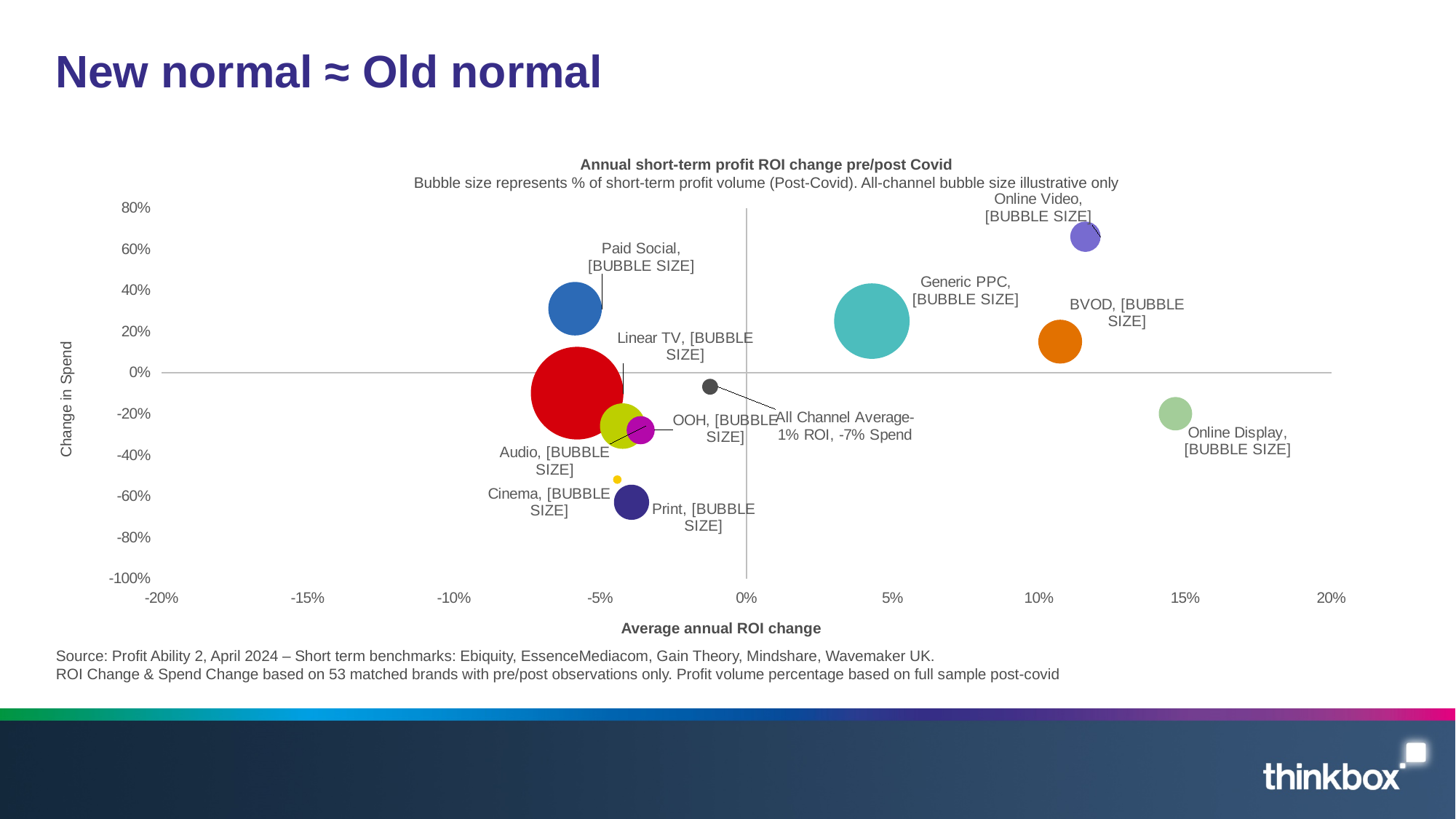
What is the label of the vertical axis? Change in Spend Is the average annual ROI change for Generic PPC greater or less than 5%? less Which channel has the lowest change in spend? Print Which has the larger change in spend, Online Video or BVOD? Online Video What kind of chart is shown on the slide? Bubble chart What is the change in spend for the All Channel Average point? -7% What is the title of the chart? Annual short-term profit ROI change pre/post Covid Which channel has the highest change in spend? Online Video Is the change in spend for Paid Social greater or less than 20%? greater Is the change in spend for Online Video greater or less than 60%? greater Which channel has the highest average annual ROI change? Online Display What is the average annual ROI change for the All Channel Average point? -1%